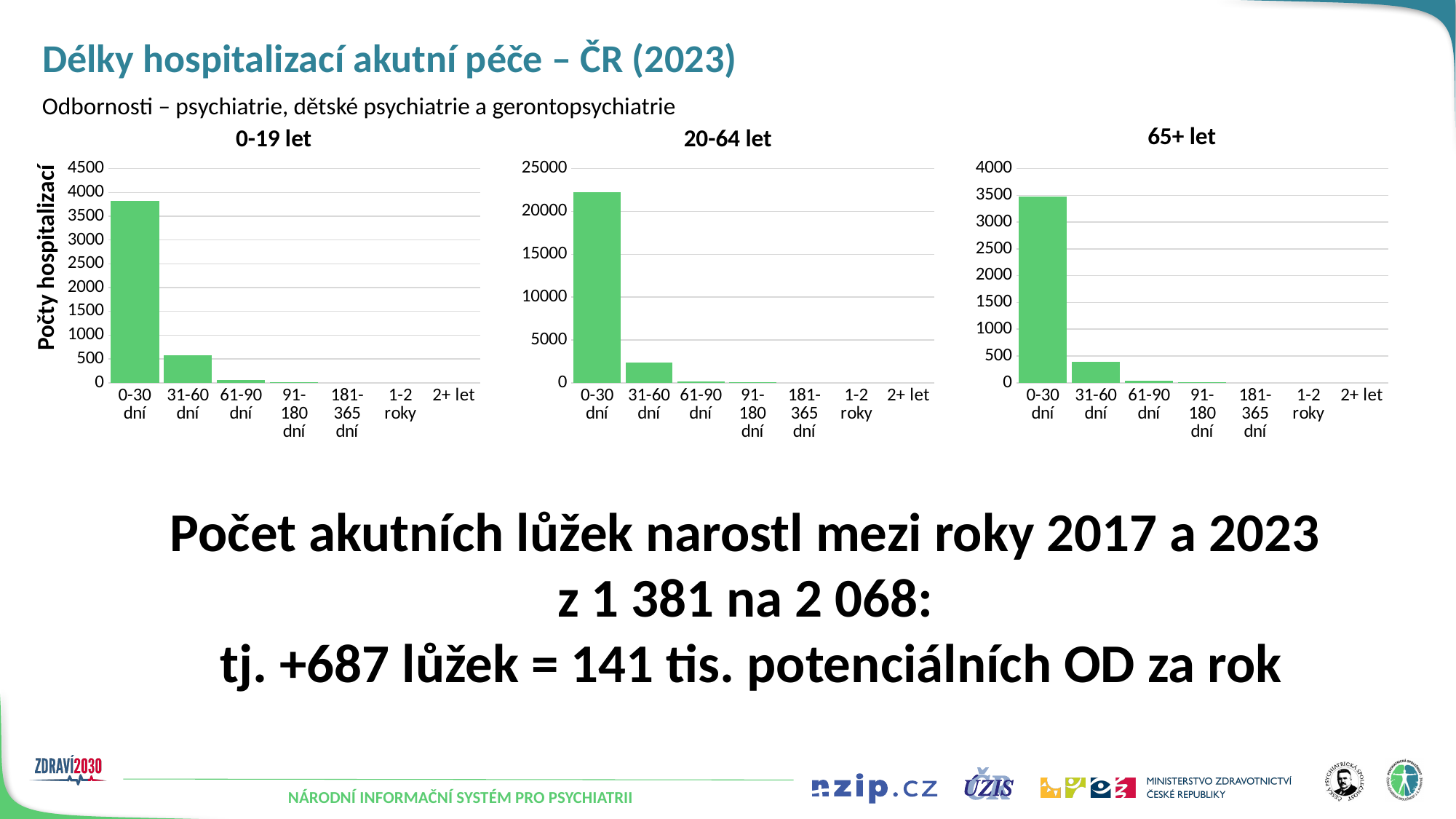
How many categories are shown on the x axis of the "65+ let" chart? 7 In the "20-64 let" chart, is the value for 0-30 dní greater or less than 20000? greater In the "20-64 let" chart, is the value for 31-60 dní greater or less than 5000? less In the "65+ let" chart, which category has the highest value? 0-30 dní In the "20-64 let" chart, do the values rise or fall from left to right along the x axis? fall What kind of chart is the "0-19 let" chart? bar chart In the "0-19 let" chart, which category has the highest value? 0-30 dní In the "0-19 let" chart, is the value for 31-60 dní greater or less than 1000? less In the "20-64 let" chart, which category has the highest value? 0-30 dní What is the y-axis label of the "0-19 let" chart? Počty hospitalizací